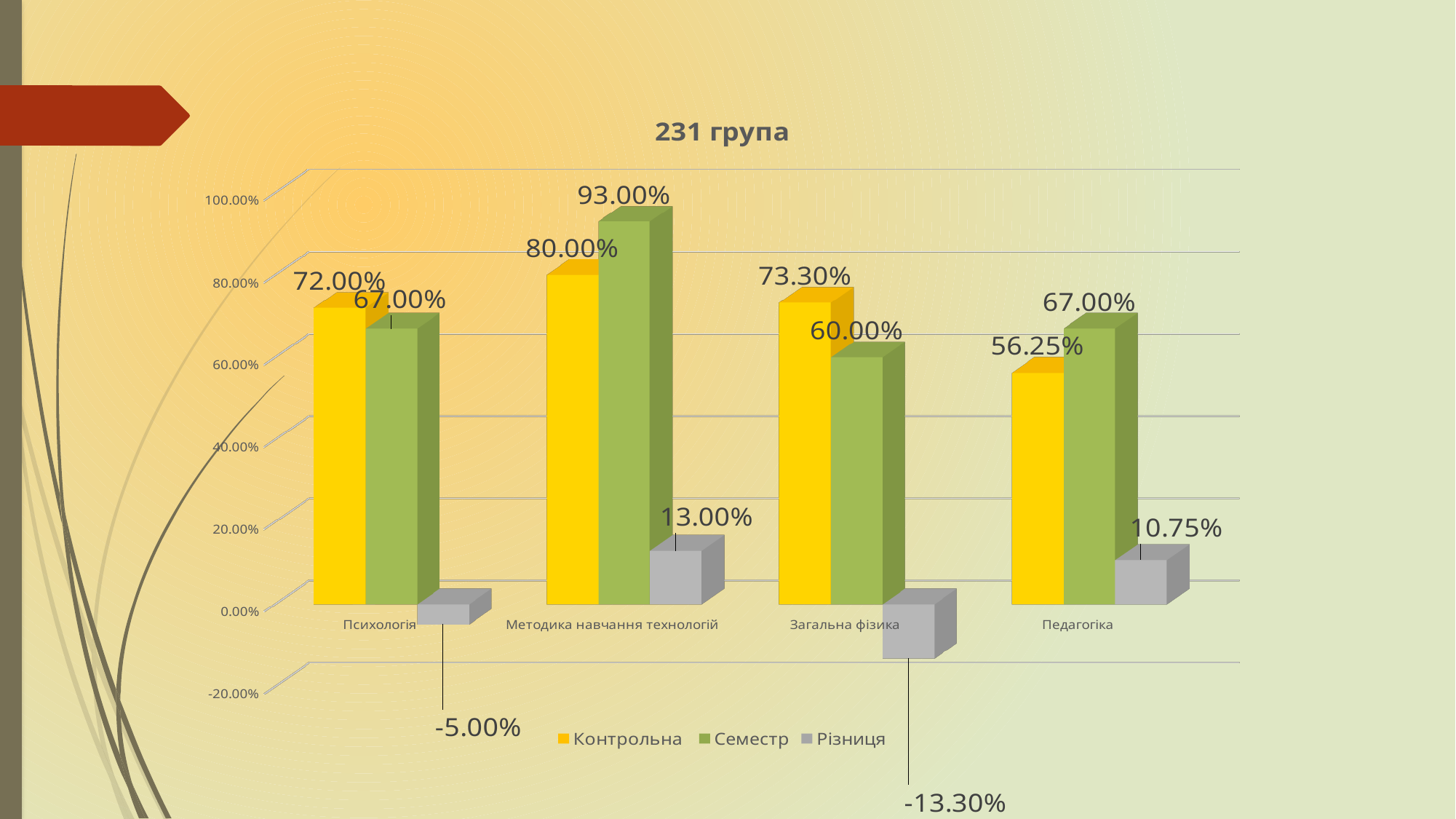
What is the Різниця value for Загальна фізика? -13.30% What is the Контрольна value for Психологія? 72.00% What is the Семестр value for Методика навчання технологій? 93.00% Which category has the lowest Контрольна value? Педагогіка What is the title of the chart? 231 група What is the Контрольна value for Педагогіка? 56.25% What type of chart is shown on the slide? bar chart What is the difference between the Семестр and Контрольна values for Педагогіка? 10.75% How many series does the legend list? 3 Which category has the highest Семестр value? Методика навчання технологій How many categories are shown on the x axis? 4 For Загальна фізика, which is larger: the Контрольна value or the Семестр value? Контрольна